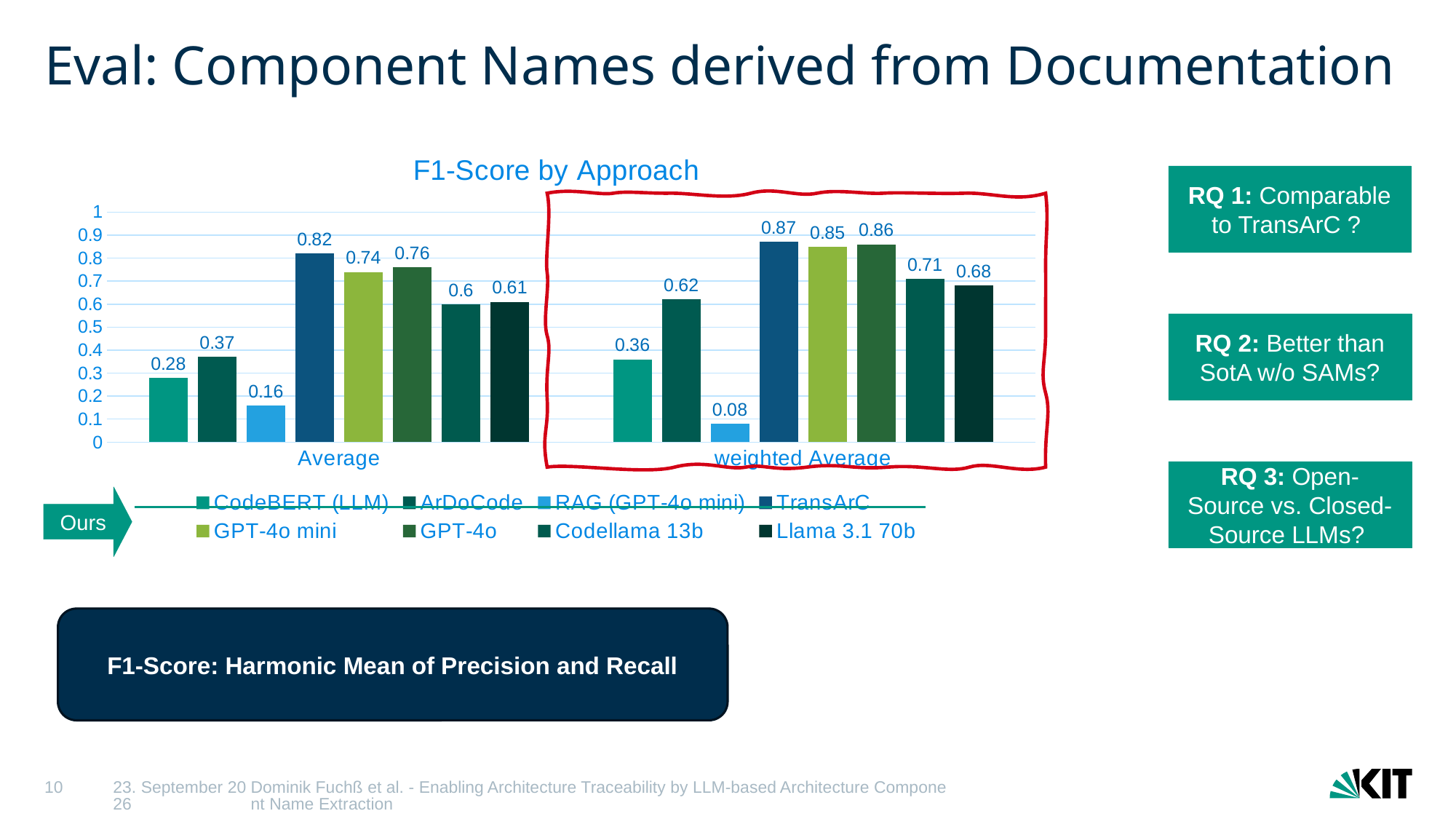
What kind of chart is shown on the slide? Bar chart What is the title of the chart? F1-Score by Approach Which has a higher F1-Score in the weighted Average category, Codellama 13b or Llama 3.1 70b? Codellama 13b Which approach has the lowest F1-Score in the Average category? RAG (GPT-4o mini) What is the F1-Score of RAG (GPT-4o mini) for the weighted Average category? 0.08 What is the difference between the weighted Average F1-Scores of ArDoCode and CodeBERT (LLM)? 0.26 What is the F1-Score of GPT-4o for the weighted Average category? 0.86 Which approach has the highest F1-Score in the weighted Average category? TransArC How many series does the legend of the F1-Score by Approach chart list? 8 What is the difference between the F1-Scores of TransArC and GPT-4o mini in the Average category? 0.08 How many categories are shown on the x axis of the chart? 2 What is the F1-Score of TransArC for the Average category? 0.82